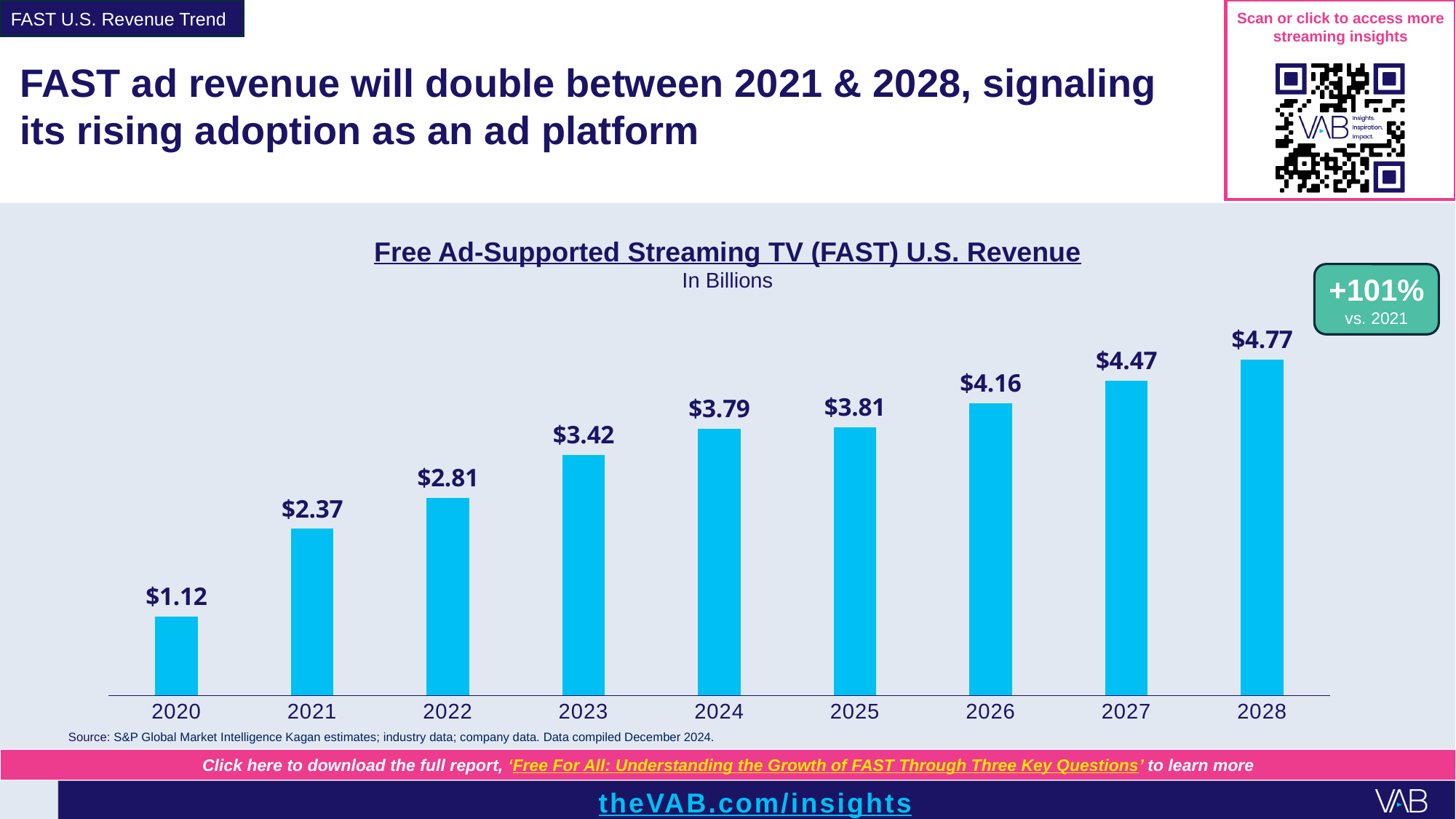
What is the title of the chart? Free Ad-Supported Streaming TV (FAST) U.S. Revenue What is the difference between the 2023 and 2022 revenue values? $0.61 Which year has the larger revenue value, 2025 or 2026? 2026 What is the FAST U.S. revenue value shown for 2020? $1.12 What is the FAST U.S. revenue value shown for 2027? $4.47 What is the difference between the 2028 and 2021 revenue values? $2.40 Which year has the lowest FAST U.S. revenue on the chart? 2020 What kind of chart is shown on the slide? Bar chart Which year has the highest FAST U.S. revenue on the chart? 2028 What is the FAST U.S. revenue value shown for 2024? $3.79 Do the revenue values rise or fall from 2020 to 2028? Rise How many years are plotted on the chart? 9